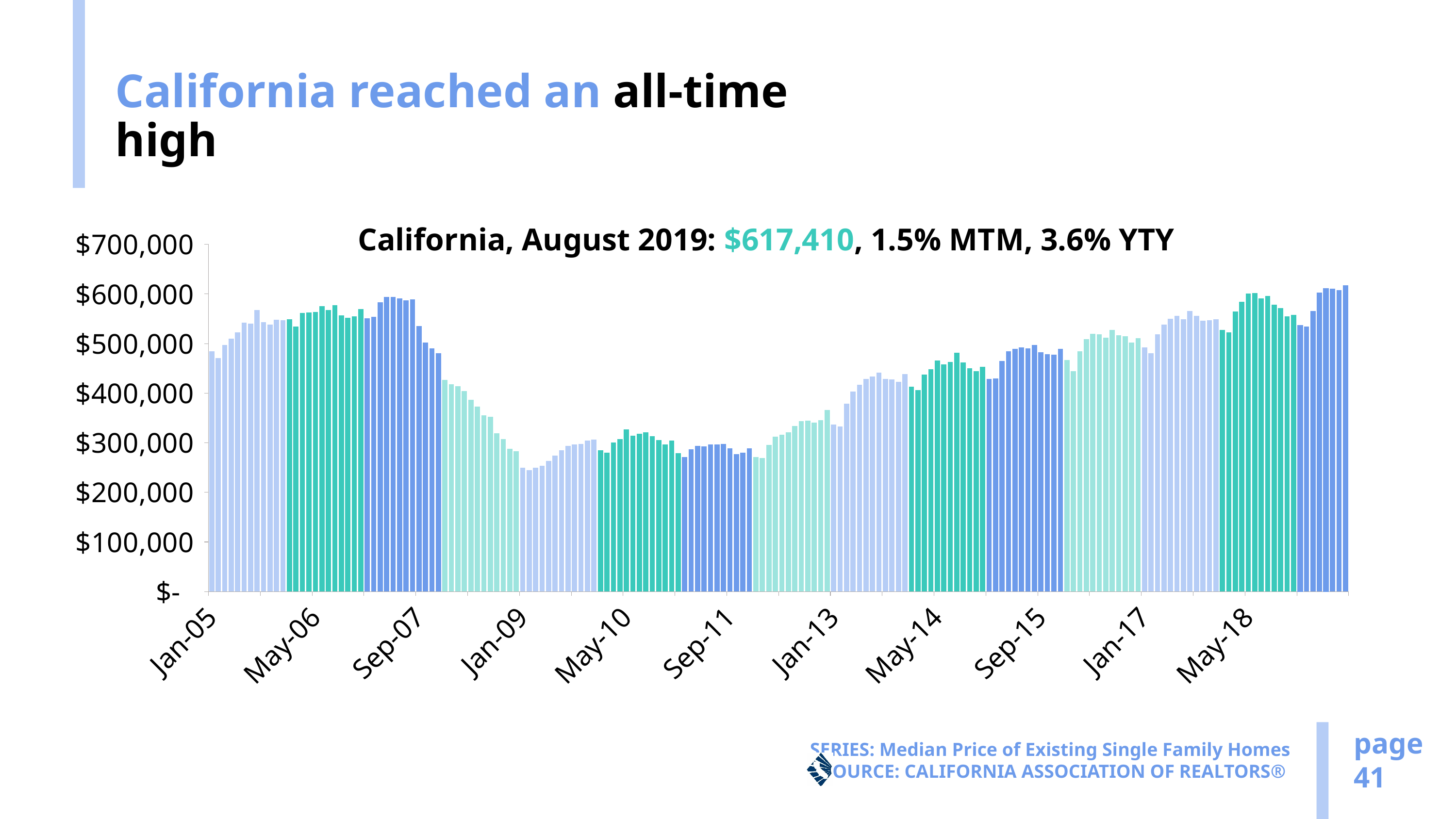
What is the month-to-month (MTM) change shown for August 2019? 1.5% Which is larger, the value for Sep-07 or the value for Jan-09? Sep-07 What is the year-to-year (YTY) change shown for August 2019? 3.6% Which month has the highest bar on the chart? August 2019 Is the value for May-18 greater or less than $500,000? greater What kind of chart is shown on the slide? bar chart Is the value for Sep-07 greater or less than $500,000? greater Is the value for May-10 greater or less than $400,000? less Do the values rise or fall between Jan-13 and May-14? rise What is the median price for California in August 2019? $617,410 Do the values rise or fall between Sep-07 and Jan-09? fall